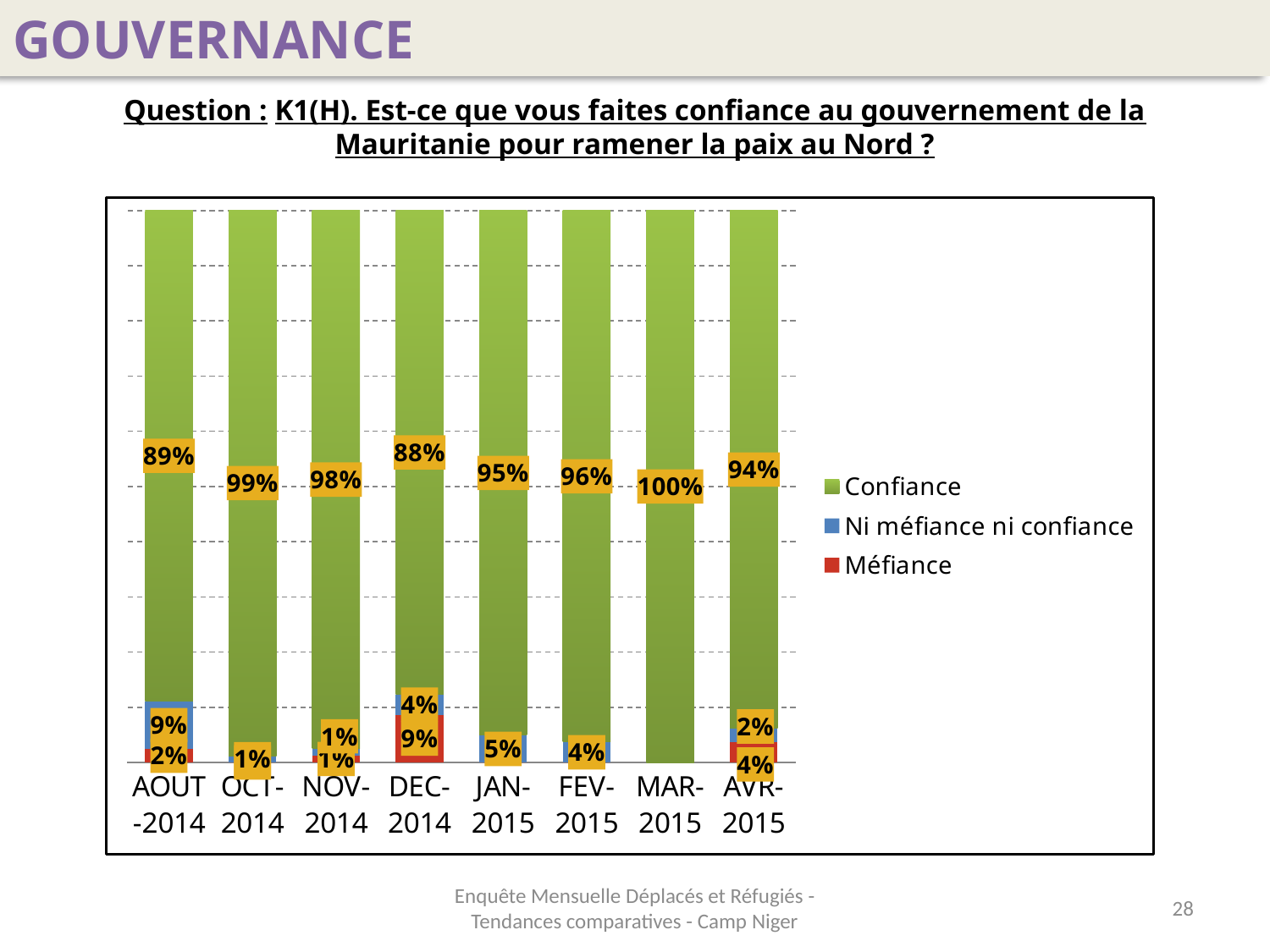
What is the difference between the Confiance values for OCT-2014 and AOUT-2014? 10% What is the Méfiance value for AOUT-2014? 2% Which month has the lowest Confiance value? DEC-2014 What is the Ni méfiance ni confiance value for AOUT-2014? 9% What is the Méfiance value for DEC-2014? 9% What is the Confiance value for DEC-2014? 88% How many series does the legend list? 3 Which month has the highest Confiance value? MAR-2015 What kind of chart is shown on the slide? Stacked bar chart Which is larger, the Confiance value for JAN-2015 or for AVR-2015? JAN-2015 How many months are shown on the x axis? 8 What is the Confiance value for MAR-2015? 100%